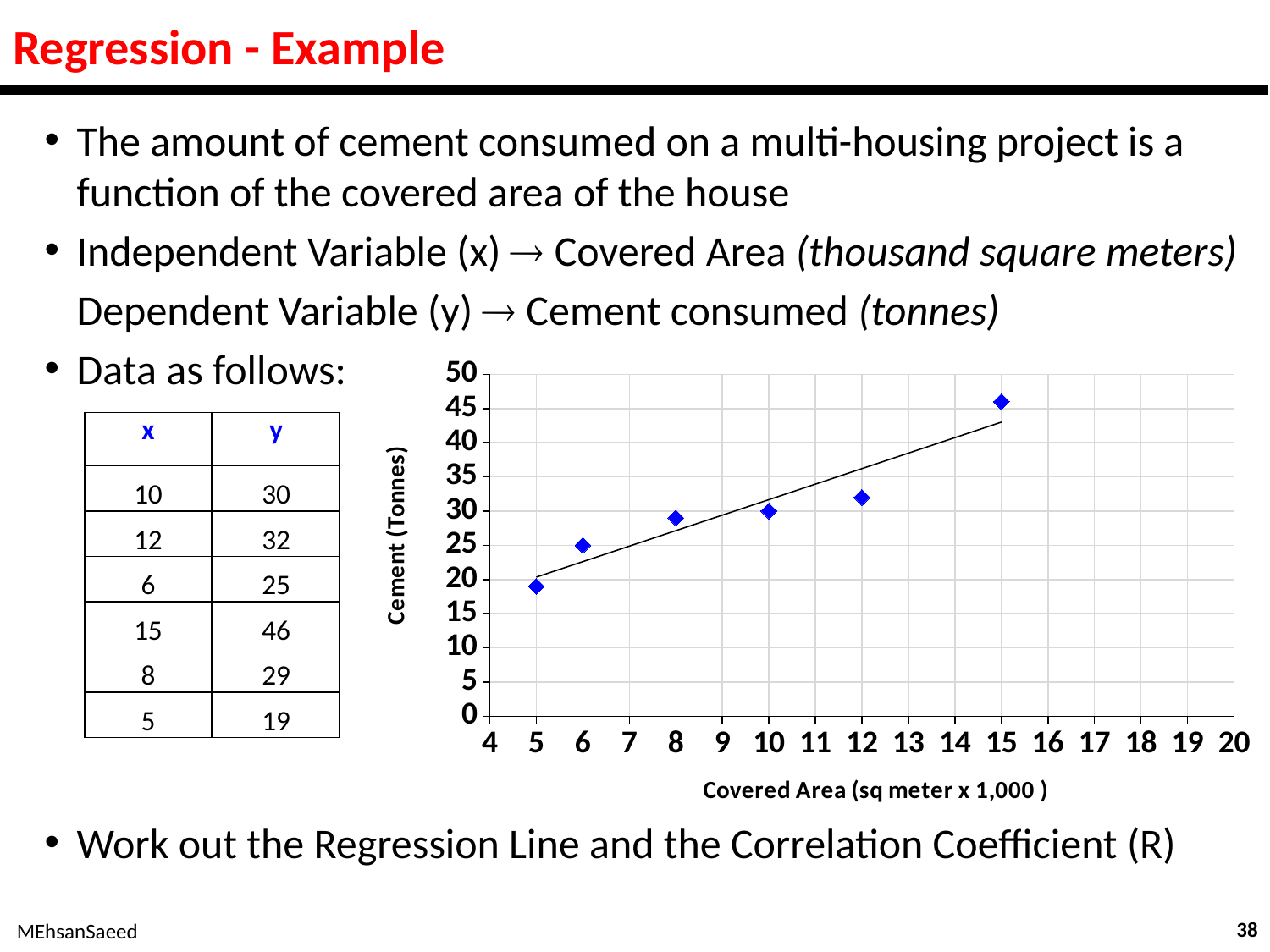
What is the cement value (y) for a covered area of 10? 30 At which covered area value is the cement consumed lowest? 5 What is the label of the y axis of the chart? Cement (Tonnes) At which covered area value is the cement consumed highest? 15 How many data points are plotted in the chart? 6 Do the plotted cement values generally rise or fall as covered area increases? rise What kind of chart is shown on the slide? scatter chart What is the cement value (y) for a covered area of 15? 46 Is the cement value for a covered area of 6 greater or less than 30? less What is the cement value (y) for a covered area of 5? 19 What is the label of the x axis of the chart? Covered Area (sq meter x 1,000 ) What is the difference in cement consumed between covered area 15 and covered area 12? 14